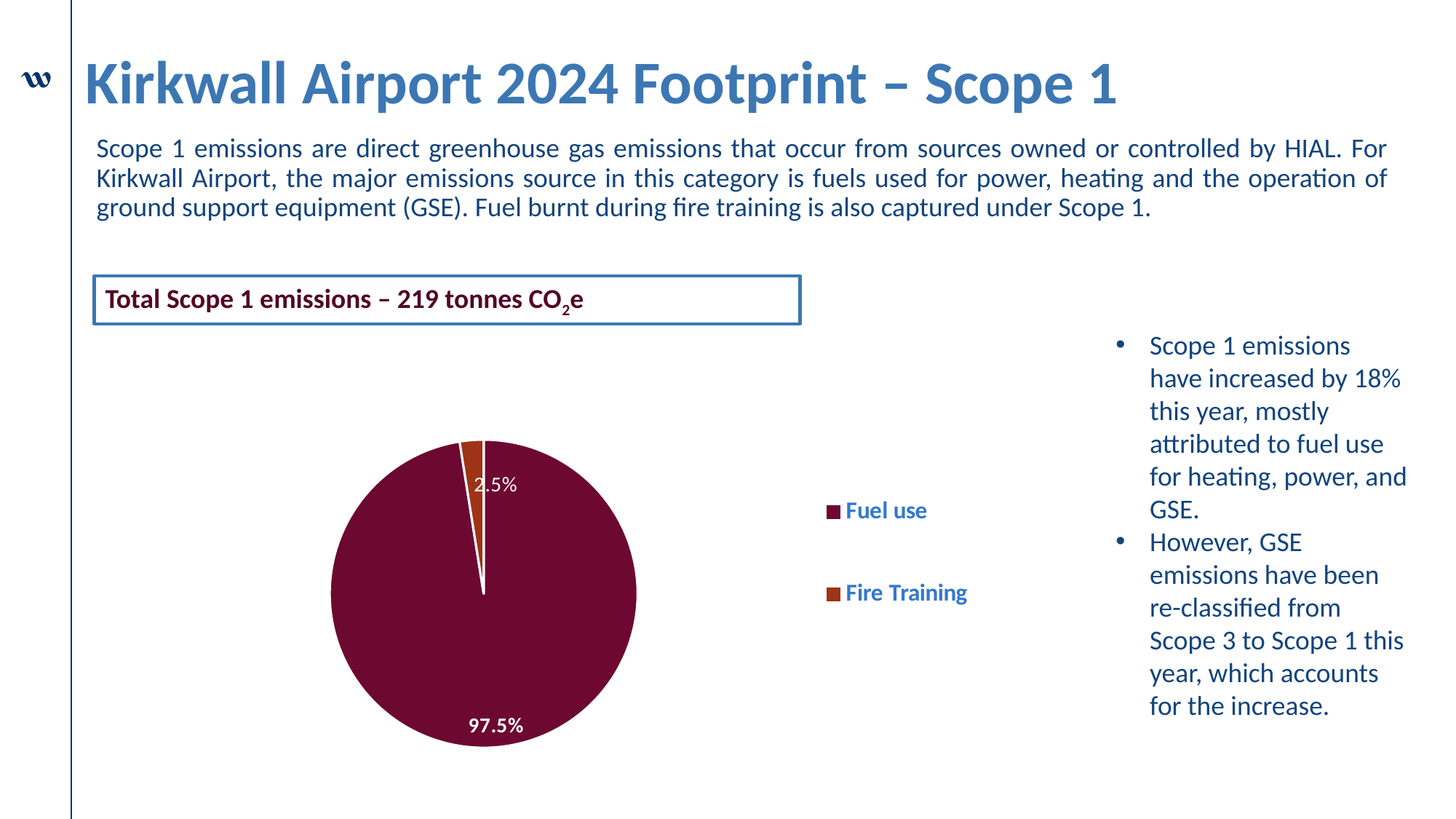
What colour is the Fire Training slice? Orange-brown What kind of chart is shown on the slide? Pie chart How many entries does the legend list? 2 What share of Scope 1 emissions does Fire Training account for? 2.5% Which category has the smallest share of the pie? Fire Training What share of Scope 1 emissions does Fuel use account for? 97.5% Which category has the largest share of the pie? Fuel use What total Scope 1 emissions figure is stated above the chart? 219 tonnes CO2e Which is larger, the share for Fuel use or the share for Fire Training? Fuel use What is the difference in percentage points between the Fuel use share and the Fire Training share? 95 percentage points How many categories does the pie chart show? 2